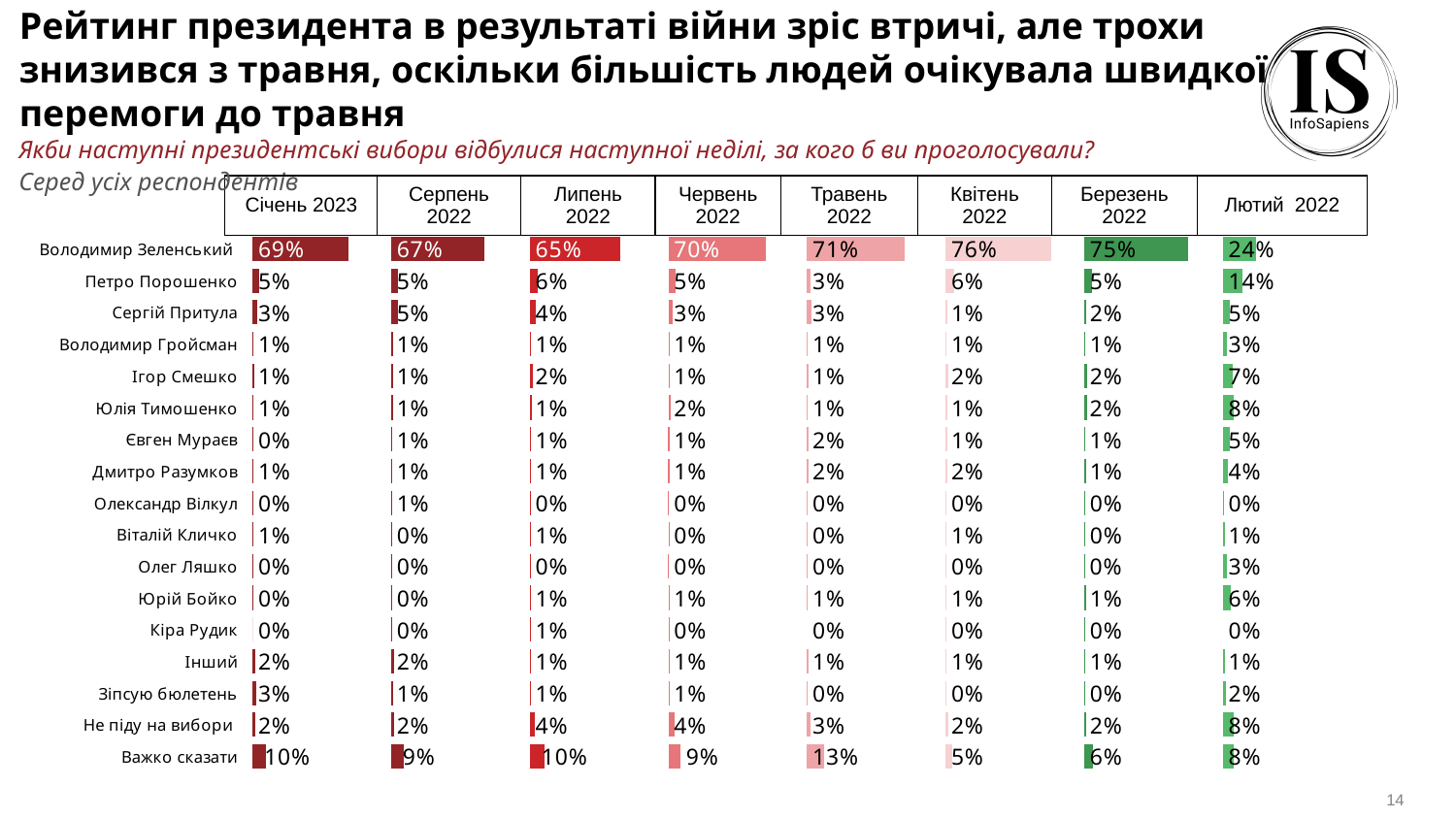
Which is larger for Сергій Притула: the value in Серпень 2022 or in Квітень 2022? Серпень 2022 What is the difference between Важко сказати in Травень 2022 and in Квітень 2022? 8% How many month columns are shown in the chart? 8 What is the difference between Володимир Зеленський's value in Березень 2022 and in Лютий 2022? 51% What is the value for Не піду на вибори in the Липень 2022 column? 4% What is the value for Важко сказати in the Травень 2022 column? 13% How many answer options (rows) are listed in the chart? 17 What is the value for Володимир Зеленський in the Січень 2023 column? 69% In which month column does Володимир Зеленський have the lowest value? Лютий 2022 In which month column does Володимир Зеленський have the highest value? Квітень 2022 What kind of chart is used to show the values in each column? Bar chart What is the value for Петро Порошенко in the Лютий 2022 column? 14%